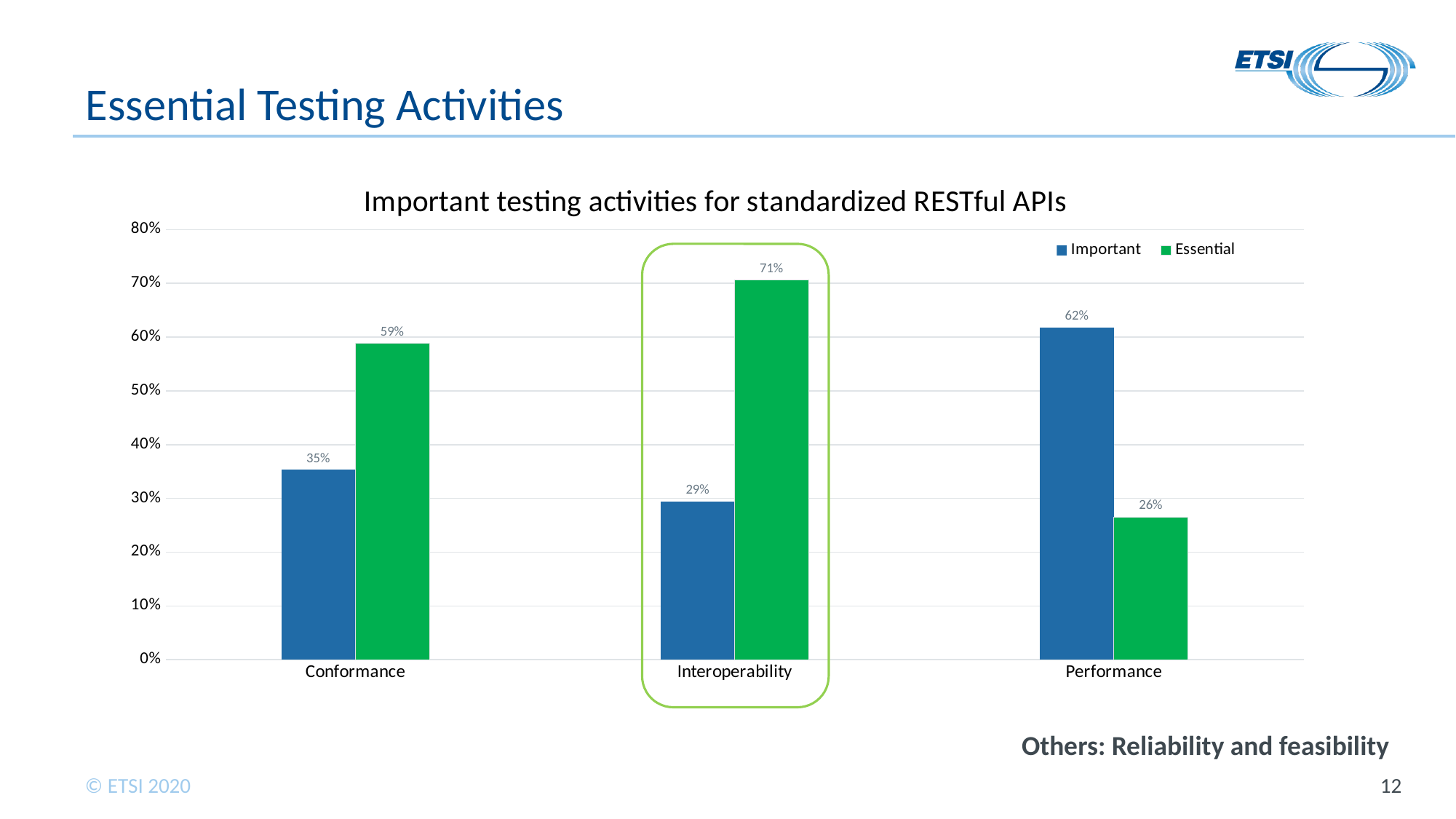
How many series does the legend list? 2 What is the Important value for Performance? 62% What is the Essential value for Interoperability? 71% For Performance, which is larger: the Important value or the Essential value? Important What is the Important value for Interoperability? 29% What is the difference between the Essential and Important values for Interoperability? 42% What kind of chart is shown on the slide? Bar chart What is the Essential value for Conformance? 59% What is the title of the chart? Important testing activities for standardized RESTful APIs How many categories are shown on the x axis? 3 Which category has the highest Essential value? Interoperability Which category has the lowest Important value? Interoperability